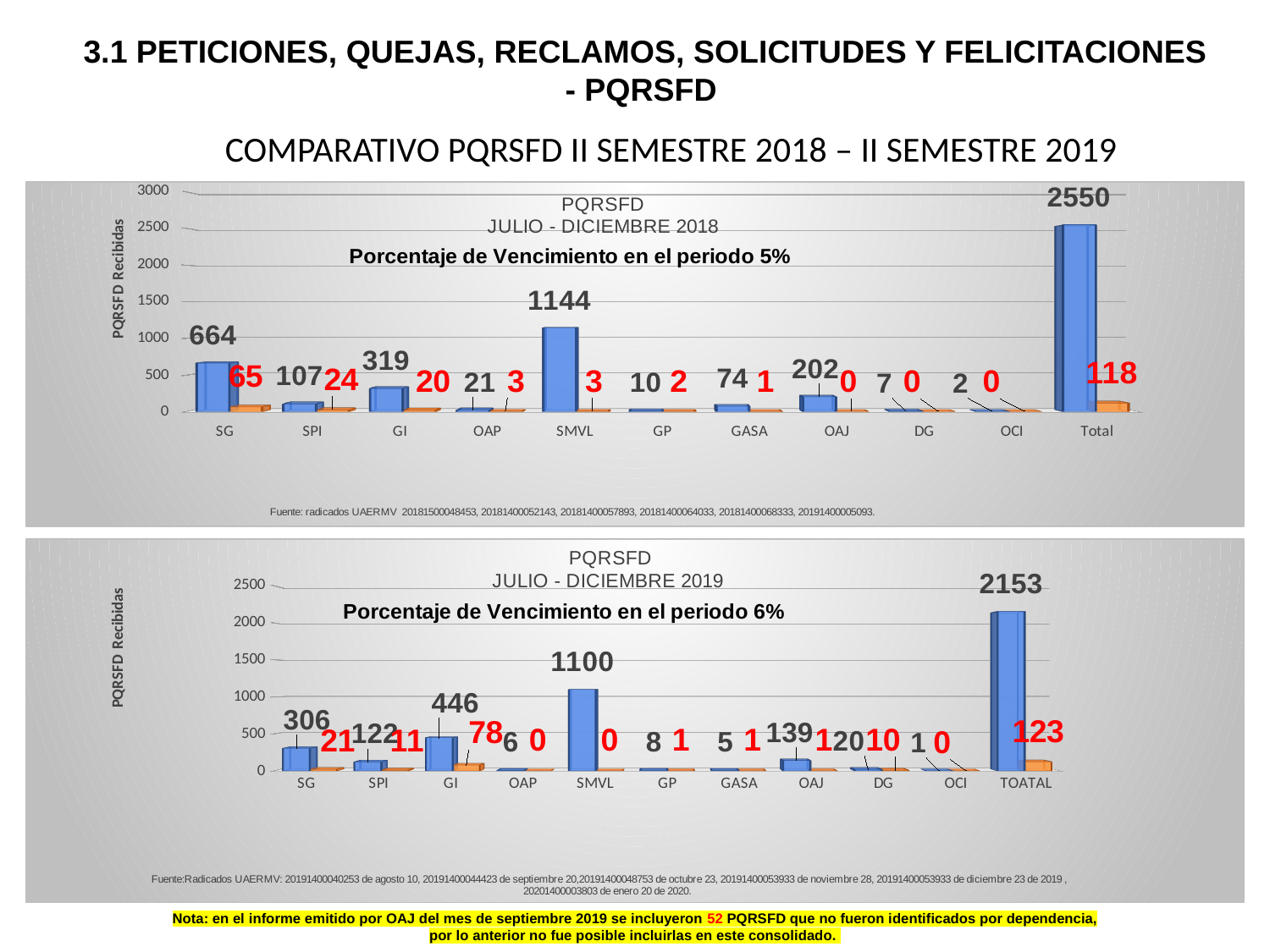
In the top chart (PQRSFD JULIO - DICIEMBRE 2018), what is the value of the blue bar for SG? 664 How many categories are shown on the x axis of the bottom chart (PQRSFD JULIO - DICIEMBRE 2019)? 11 What type of chart is the top chart (PQRSFD JULIO - DICIEMBRE 2018)? Bar chart In the top chart (PQRSFD JULIO - DICIEMBRE 2018), what is the value of the blue bar for SMVL? 1144 In the top chart (PQRSFD JULIO - DICIEMBRE 2018), excluding the Total bar, which dependency has the highest blue bar? SMVL In the bottom chart (PQRSFD JULIO - DICIEMBRE 2019), which is larger, the blue bar for SG or the blue bar for OAJ? SG In the top chart (PQRSFD JULIO - DICIEMBRE 2018), what is the red-labelled value shown for Total? 118 In the bottom chart (PQRSFD JULIO - DICIEMBRE 2019), what is the value of the TOATAL blue bar? 2153 In the top chart (PQRSFD JULIO - DICIEMBRE 2018), what is the difference between the blue bar values for SG and GI? 345 In the top chart (PQRSFD JULIO - DICIEMBRE 2018), which dependency has the lowest blue bar value? OCI In the bottom chart (PQRSFD JULIO - DICIEMBRE 2019), what is the value of the blue bar for GI? 446 In the bottom chart (PQRSFD JULIO - DICIEMBRE 2019), is the blue bar for SMVL greater or less than 1000? greater